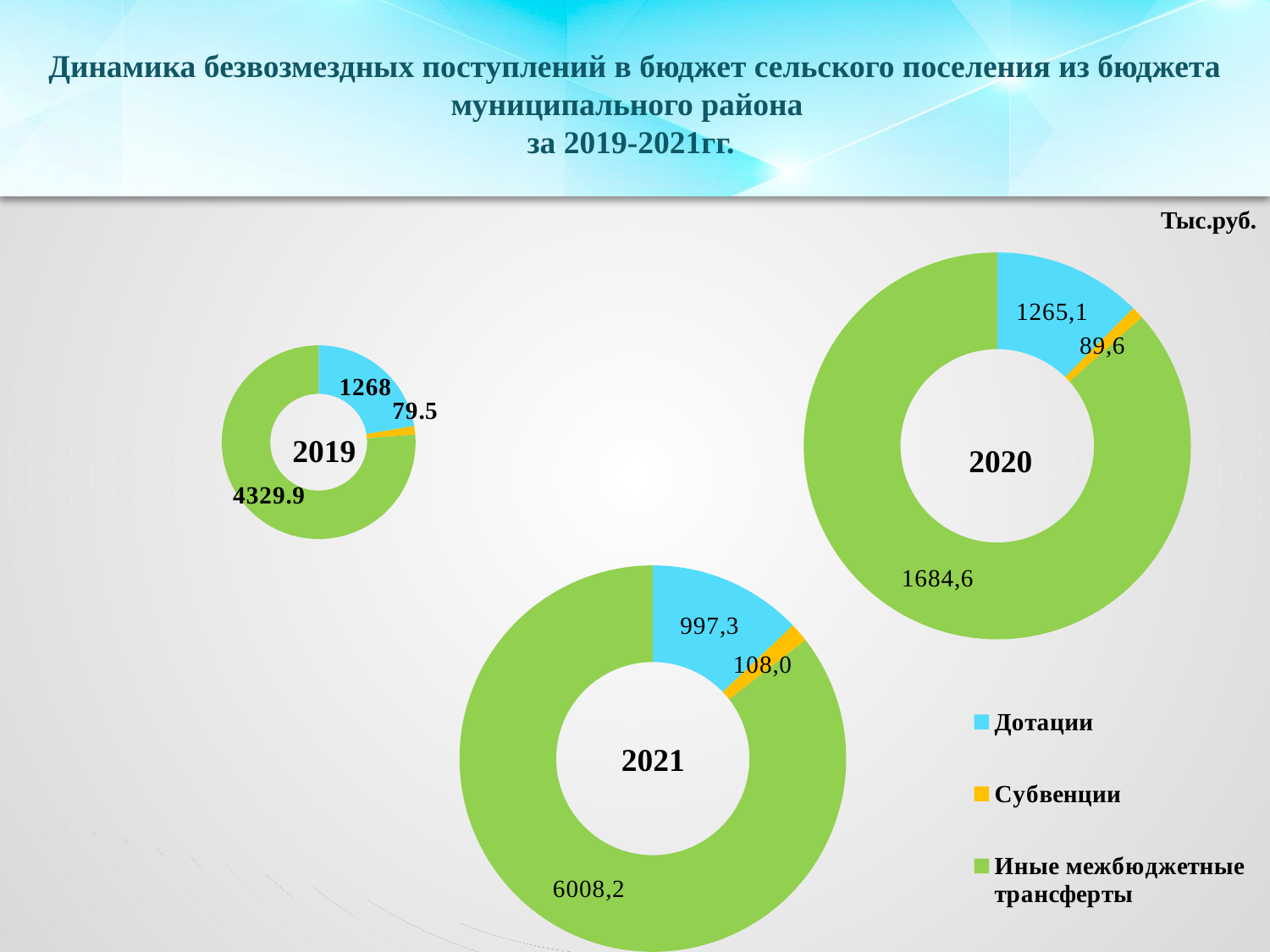
In the 2019 chart, what is the value for Субвенции? 79.5 In the 2021 chart, which category has the largest value? Иные межбюджетные трансферты In the 2021 chart, which is larger: Дотации or Субвенции? Дотации In the 2021 chart, what is the value for Субвенции? 108,0 How many categories does the legend list? 3 In the 2019 chart, what is the value for Иные межбюджетные трансферты? 4329.9 In the 2019 chart, which category has the smallest value? Субвенции In the 2019 chart, what is the value for Дотации? 1268 What type of chart is used for the 2020 data? Doughnut chart In the 2020 chart, what is the value for Субвенции? 89,6 In the 2021 chart, what is the value for Иные межбюджетные трансферты? 6008,2 In the 2020 chart, what is the value for Дотации? 1265,1